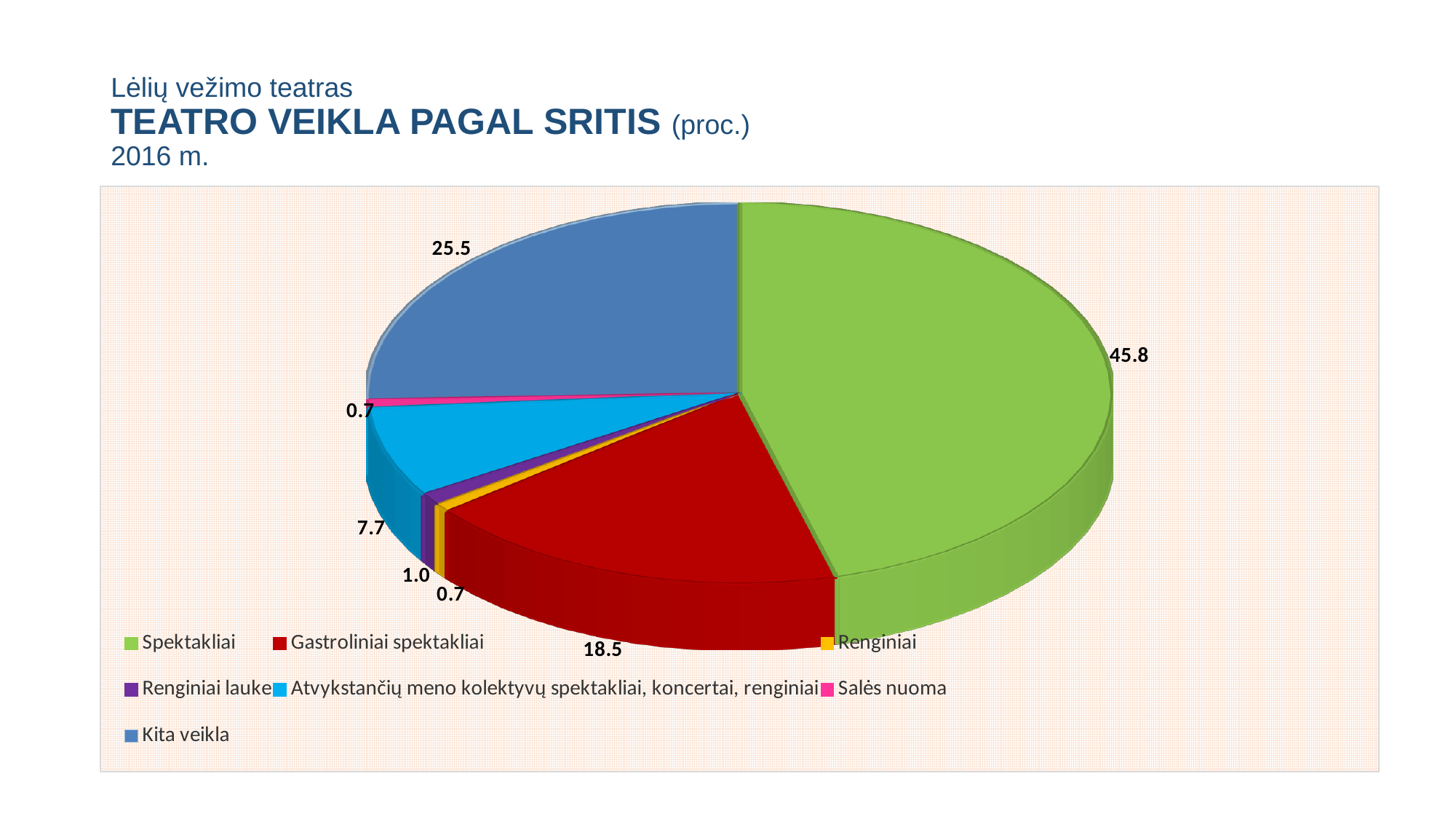
Which category has the largest share of the pie? Spektakliai What is the value for Spektakliai? 45.8 How many categories does the legend list? 7 What is the value for Kita veikla? 25.5 What is the difference between the values for Gastroliniai spektakliai and Atvykstančių meno kolektyvų spektakliai, koncertai, renginiai? 10.8 What is the difference between the values for Spektakliai and Kita veikla? 20.3 What type of chart is shown on the slide? pie chart What colour is the slice for Salės nuoma? pink What is the value for Gastroliniai spektakliai? 18.5 What is the value for Atvykstančių meno kolektyvų spektakliai, koncertai, renginiai? 7.7 Which is larger, Gastroliniai spektakliai or Kita veikla? Kita veikla What is the value for Renginiai lauke? 1.0